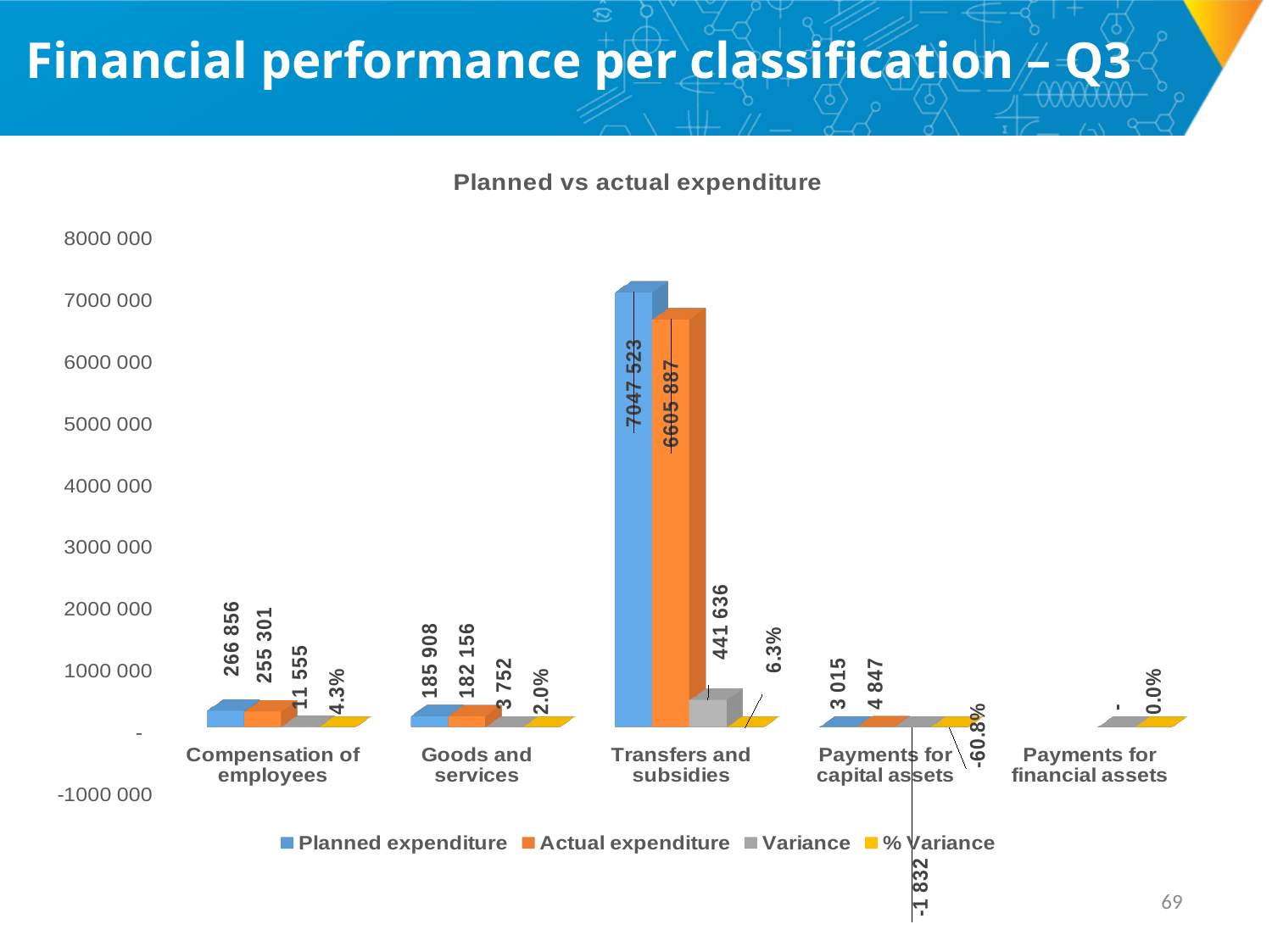
What is the variance for Goods and services? 3 752 Which category has the lowest % Variance? Payments for capital assets How many categories are shown on the x axis? 5 What is the actual expenditure for Compensation of employees? 255 301 Is the planned expenditure for Transfers and subsidies greater or less than 7000 000? greater Which category has the highest planned expenditure? Transfers and subsidies Is the planned expenditure for Goods and services larger or smaller than the actual expenditure for Goods and services? larger How many series does the legend list? 4 What is the planned expenditure for Transfers and subsidies? 7047 523 What type of chart is shown? bar chart What is the difference between planned and actual expenditure for Transfers and subsidies? 441 636 What is the % Variance for Payments for capital assets? -60.8%